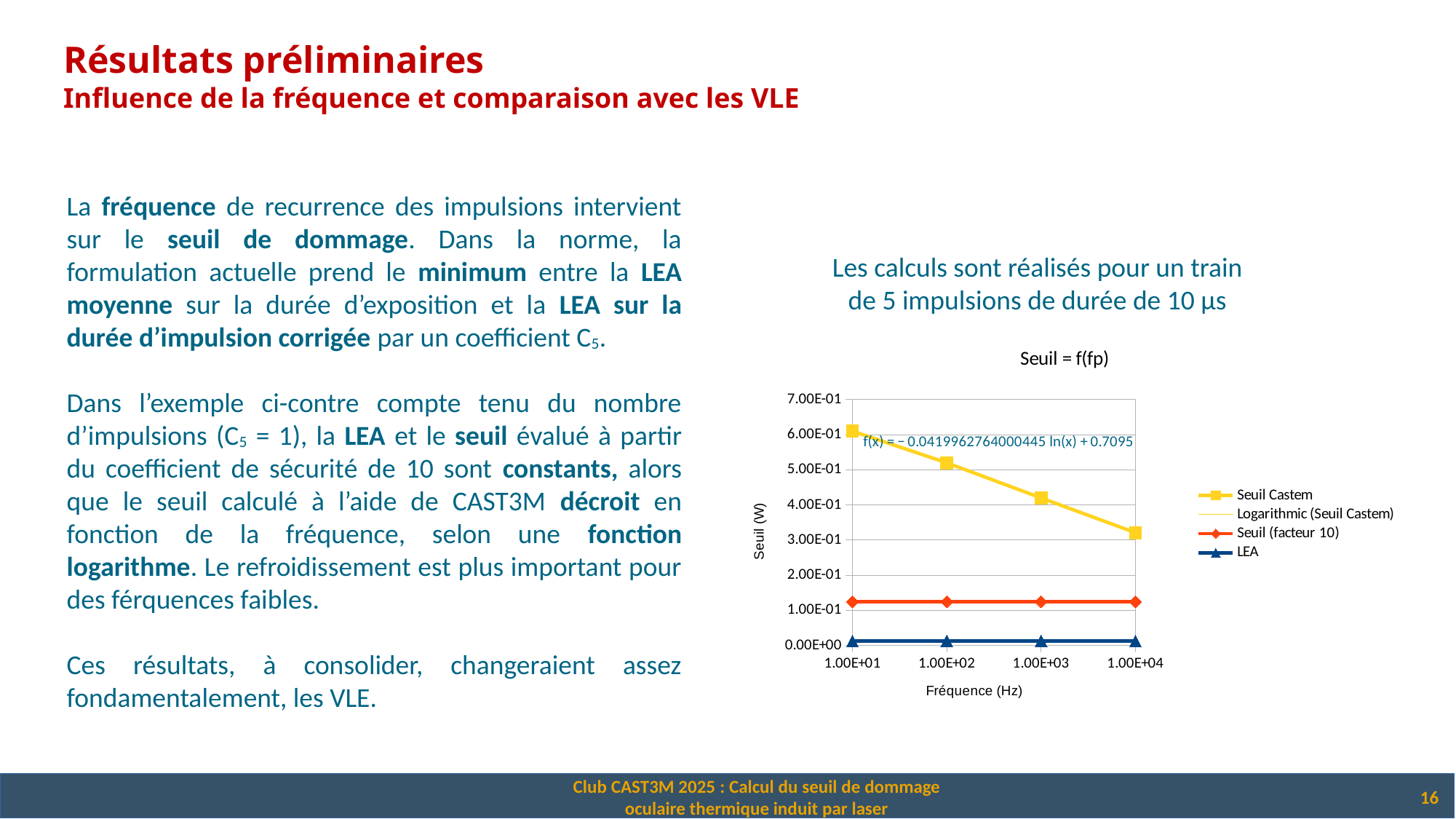
What is the label of the x axis of the chart? Fréquence (Hz) What kind of chart is shown on the slide? line chart Which series has the lowest values across the chart? LEA What is the title of the chart? Seuil = f(fp) How many frequency points are plotted along the x axis of the chart? 4 Does the Seuil Castem series rise or fall as the frequency increases along the x axis? falls How many entries does the legend of the chart list? 4 Is the LEA value at 1.00E+01 Hz greater or less than 1.00E-01? less Is the Seuil Castem value at 1.00E+02 Hz greater or less than 6.00E-01? less At 1.00E+04 Hz, which is larger: Seuil Castem or Seuil (facteur 10)? Seuil Castem Is the Seuil (facteur 10) value at 1.00E+03 Hz greater or less than 2.00E-01? less Which series has the highest value at 1.00E+01 Hz? Seuil Castem